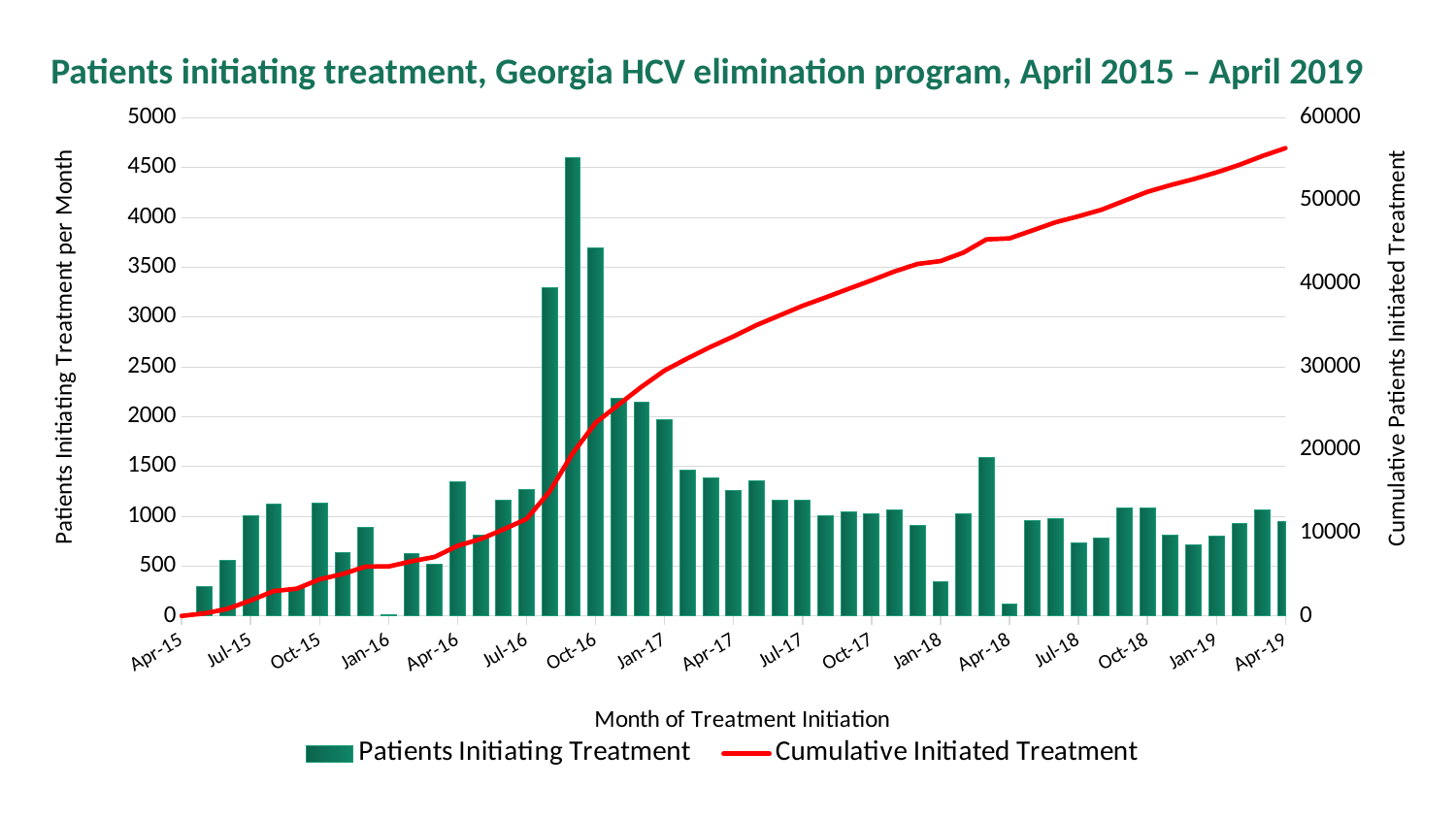
Which month has more Patients Initiating Treatment, Apr-15 or Apr-19? Apr-19 Is the Cumulative Initiated Treatment value at Jul-17 greater or less than 30000? greater Is the value for Patients Initiating Treatment in Apr-19 greater or less than 500? greater What kind of chart is shown on the slide? A combination bar and line chart How many series does the legend list? 2 Is the highest monthly value for Patients Initiating Treatment greater or less than 4000? greater What are the two series named in the legend? Patients Initiating Treatment and Cumulative Initiated Treatment Does the Cumulative Initiated Treatment line rise or fall from April 2015 to April 2019? Rise What is the title of the left vertical axis? Patients Initiating Treatment per Month